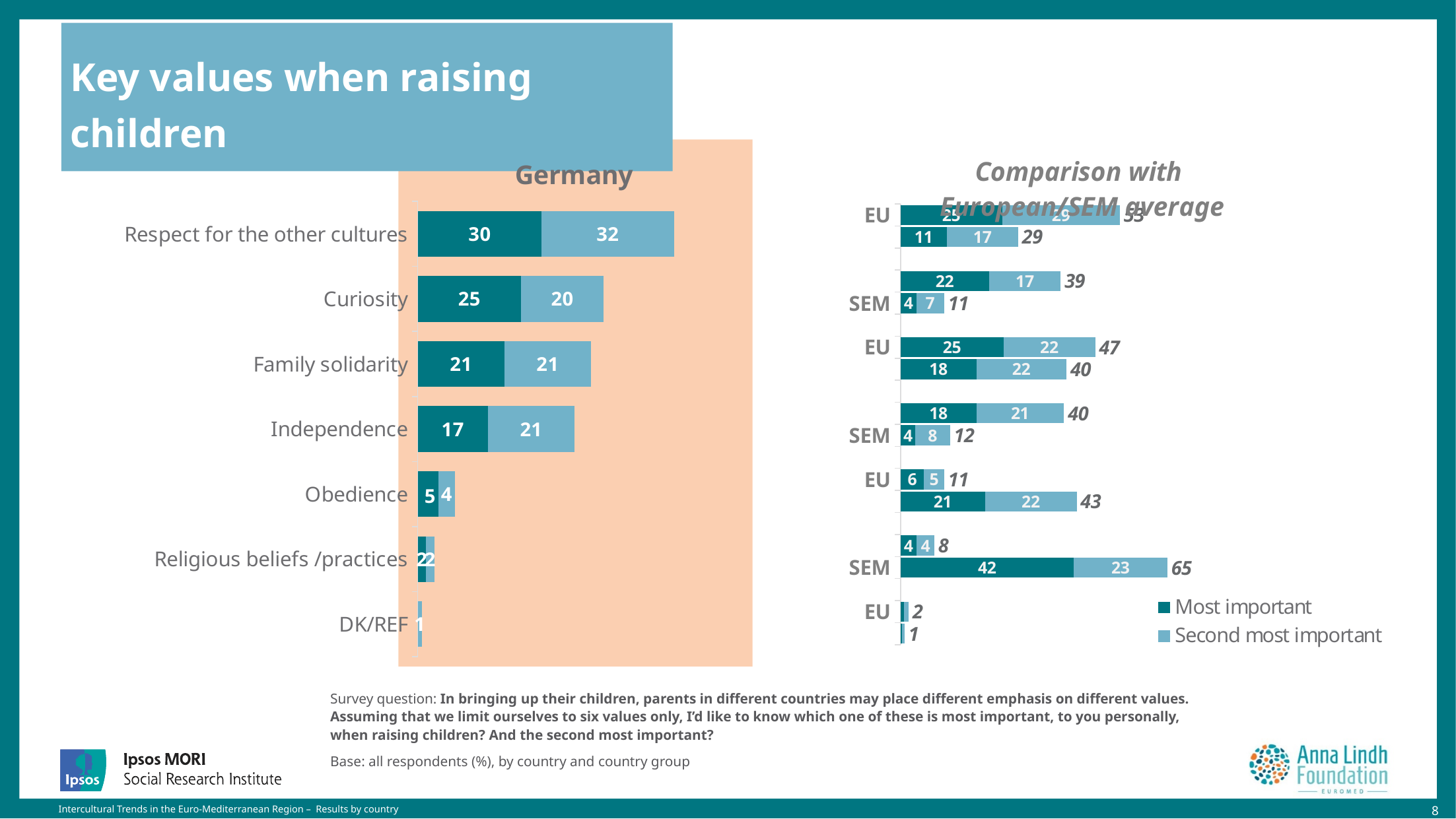
In the Germany chart, what is the difference between the 'Most important' values for Curiosity and Independence? 8 In the Germany chart, what is the 'Second most important' value for Curiosity? 20 In the Germany chart, what is the 'Second most important' value for Independence? 21 In the Germany chart, what is the combined total of the two segments for Respect for the other cultures? 62 In the Germany chart, what is the combined total of the two segments for Family solidarity? 42 In the Germany chart, which is larger: the 'Most important' value for Obedience or for Curiosity? Curiosity How many series does the legend of the comparison chart list? 2 In the Germany chart, which value has the highest 'Most important' share? Respect for the other cultures How many categories are shown in the Germany chart? 7 In the Germany chart, what is the 'Most important' value for Respect for the other cultures? 30 In the 'Comparison with European/SEM average' chart, what is the largest total shown at the end of a bar? 65 What type of chart is the Germany chart? Stacked bar chart